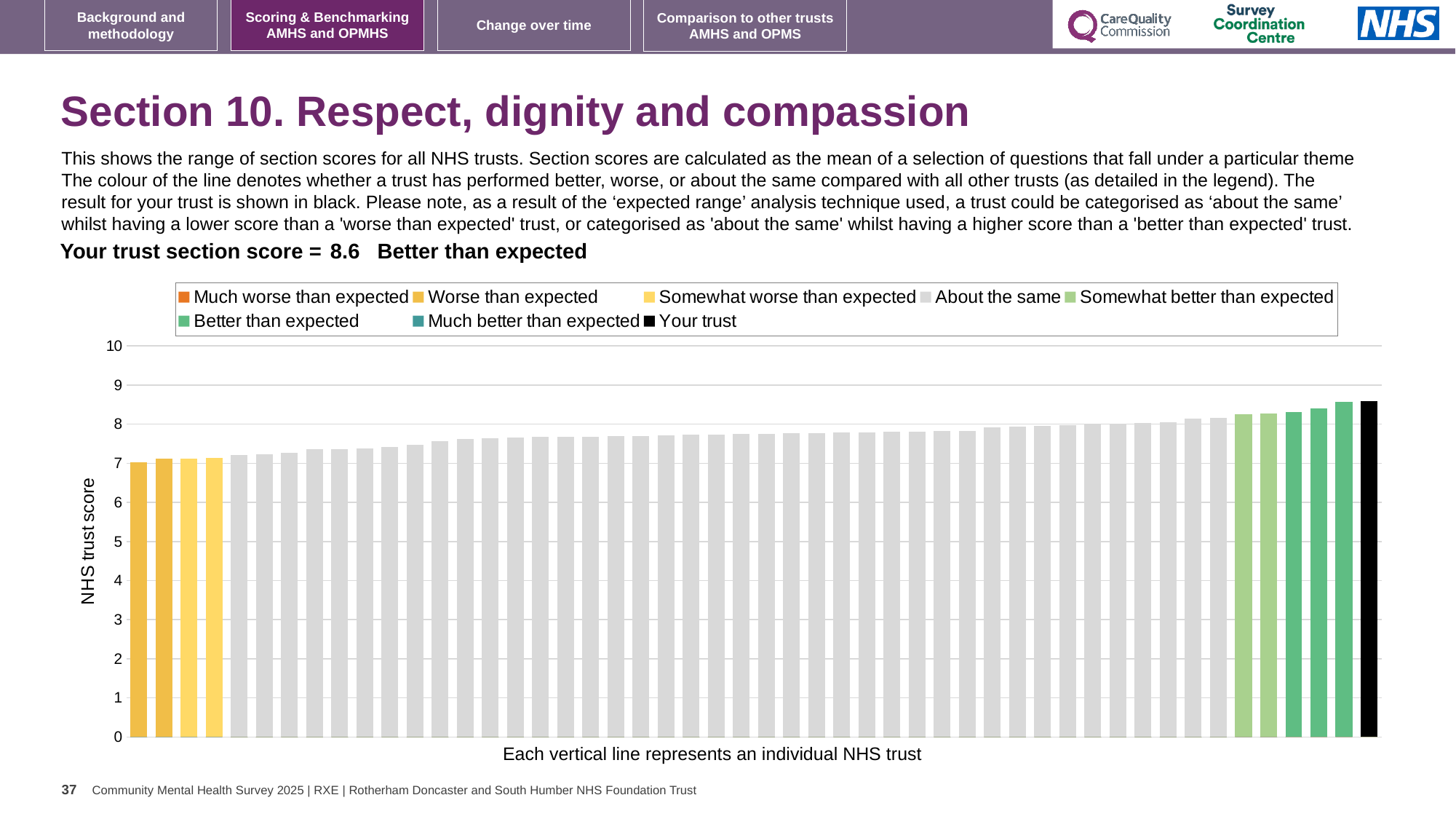
Which performance category is your trust placed in for this section? Better than expected Is the value of the leftmost (lowest) bar greater or less than 6? greater Do the bar values rise or fall from left to right across the chart? rise What is the section score for your trust? 8.6 What colour is used for the 'Your trust' bar? black Which legend category does the lowest bar on the chart belong to? Worse than expected Is the value of the black 'Your trust' bar greater or less than 8? greater Is the value of the highest bar greater or less than 9? less What is the label on the vertical axis of the chart? NHS trust score What kind of chart is shown on the slide? bar chart How many bars are coloured as 'Somewhat better than expected' (light green)? 2 How many entries does the chart legend list? 8